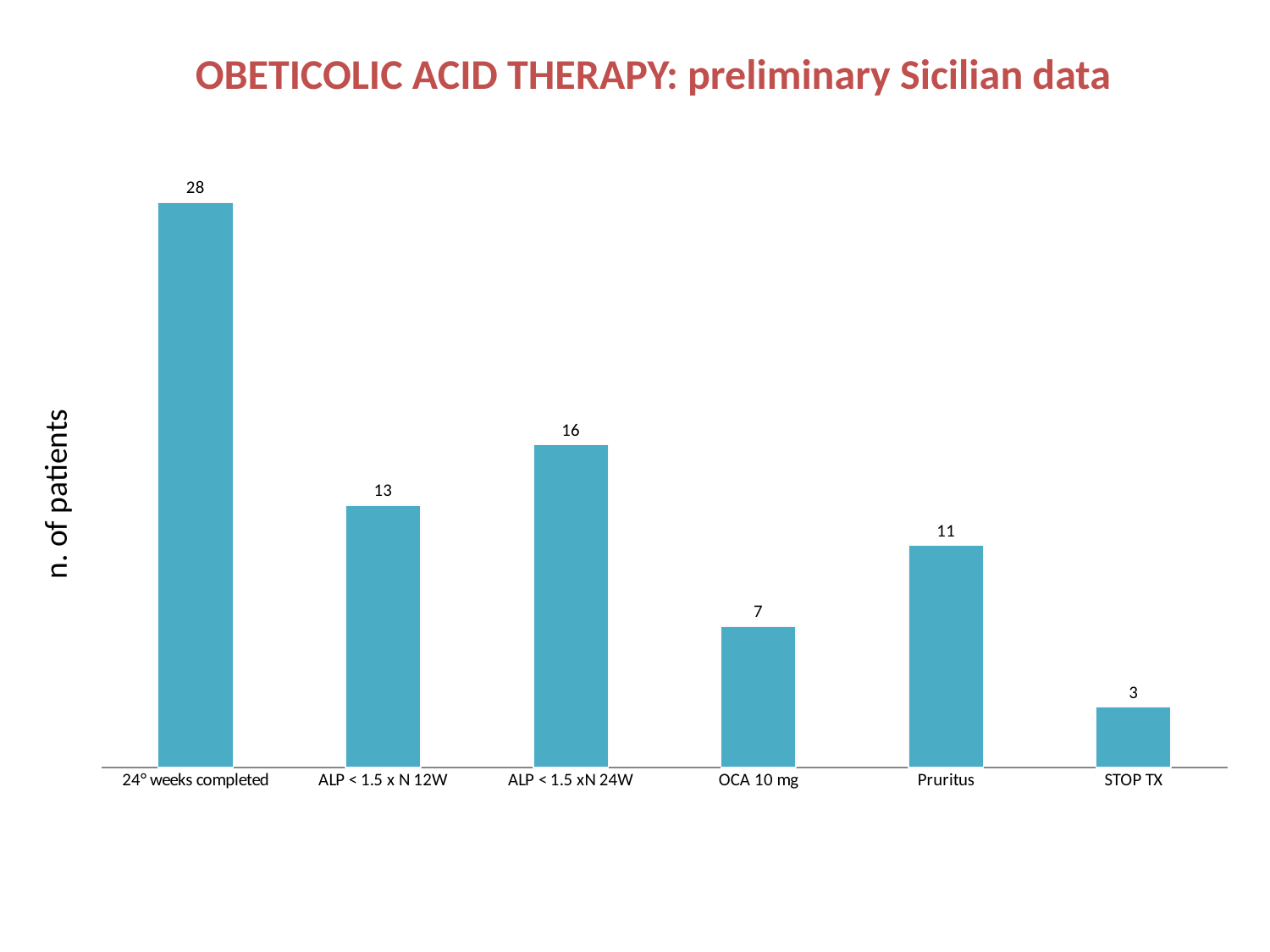
How many patients completed 24 weeks? 28 Which category has the highest number of patients? 24° weeks completed Which is larger, Pruritus or OCA 10 mg? Pruritus How many categories are shown on the x axis? 6 What is the difference between ALP < 1.5 xN 24W and ALP < 1.5 x N 12W? 3 What is the label of the y axis? n. of patients Which category has the lowest number of patients? STOP TX What is the value for Pruritus? 11 What is the value for OCA 10 mg? 7 What kind of chart is shown on the slide? bar chart What is the title of the slide? OBETICOLIC ACID THERAPY: preliminary Sicilian data What is the difference between 24° weeks completed and STOP TX? 25